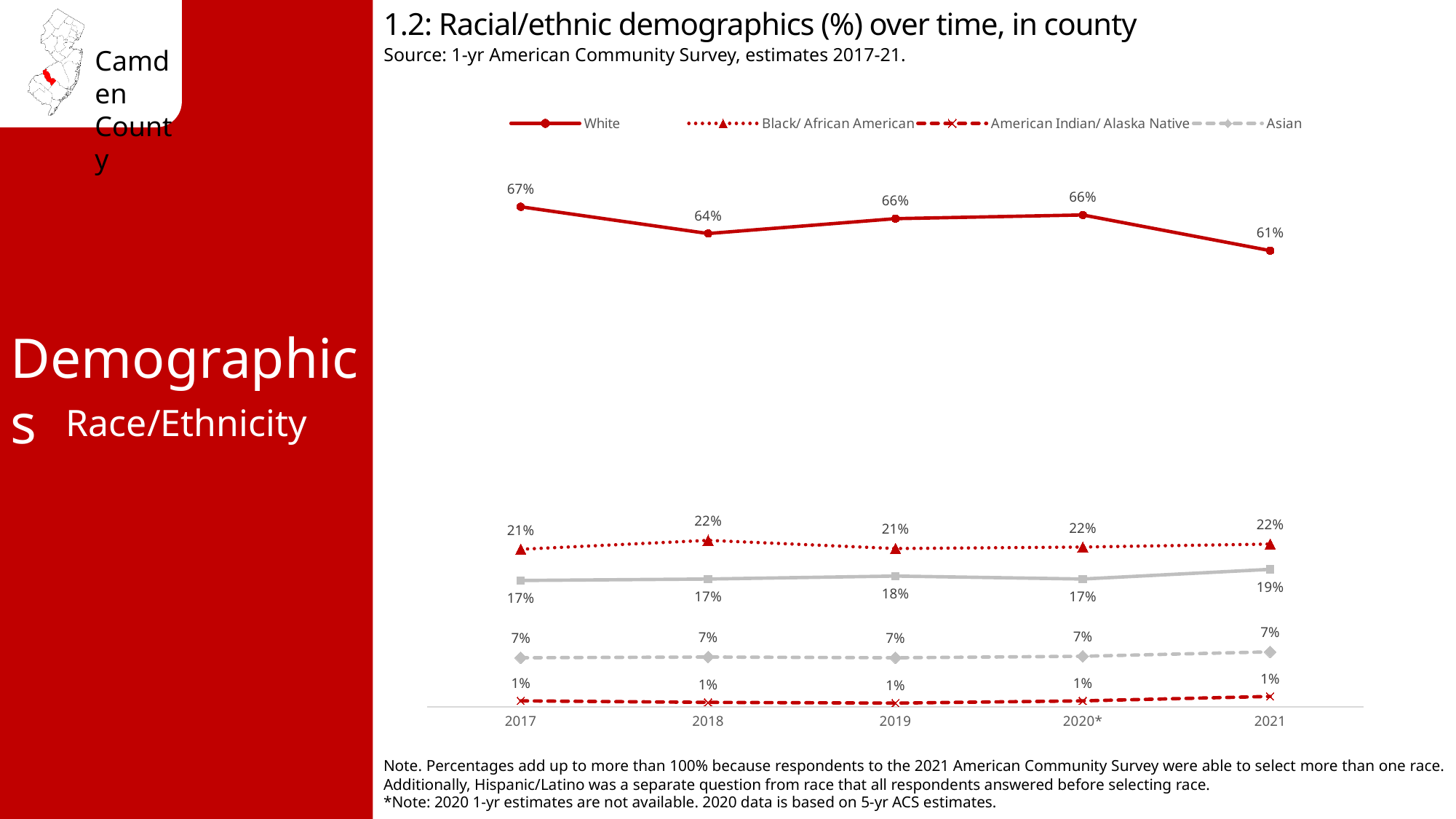
What is the value for Asian in 2019? 7% What is the difference between the White value in 2017 and in 2021? 6 percentage points How many series does the legend list? 4 What is the value for American Indian/ Alaska Native in 2021? 1% Which is larger for White: the 2018 value or the 2019 value? 2019 What kind of chart is this? Line chart What is the value for White in 2017? 67% What is the value for White in 2021? 61% In which year is the White series at its lowest? 2021 How many years are shown on the x axis? 5 What is the value for Black/ African American in 2018? 22% In which year is the White series at its highest? 2017